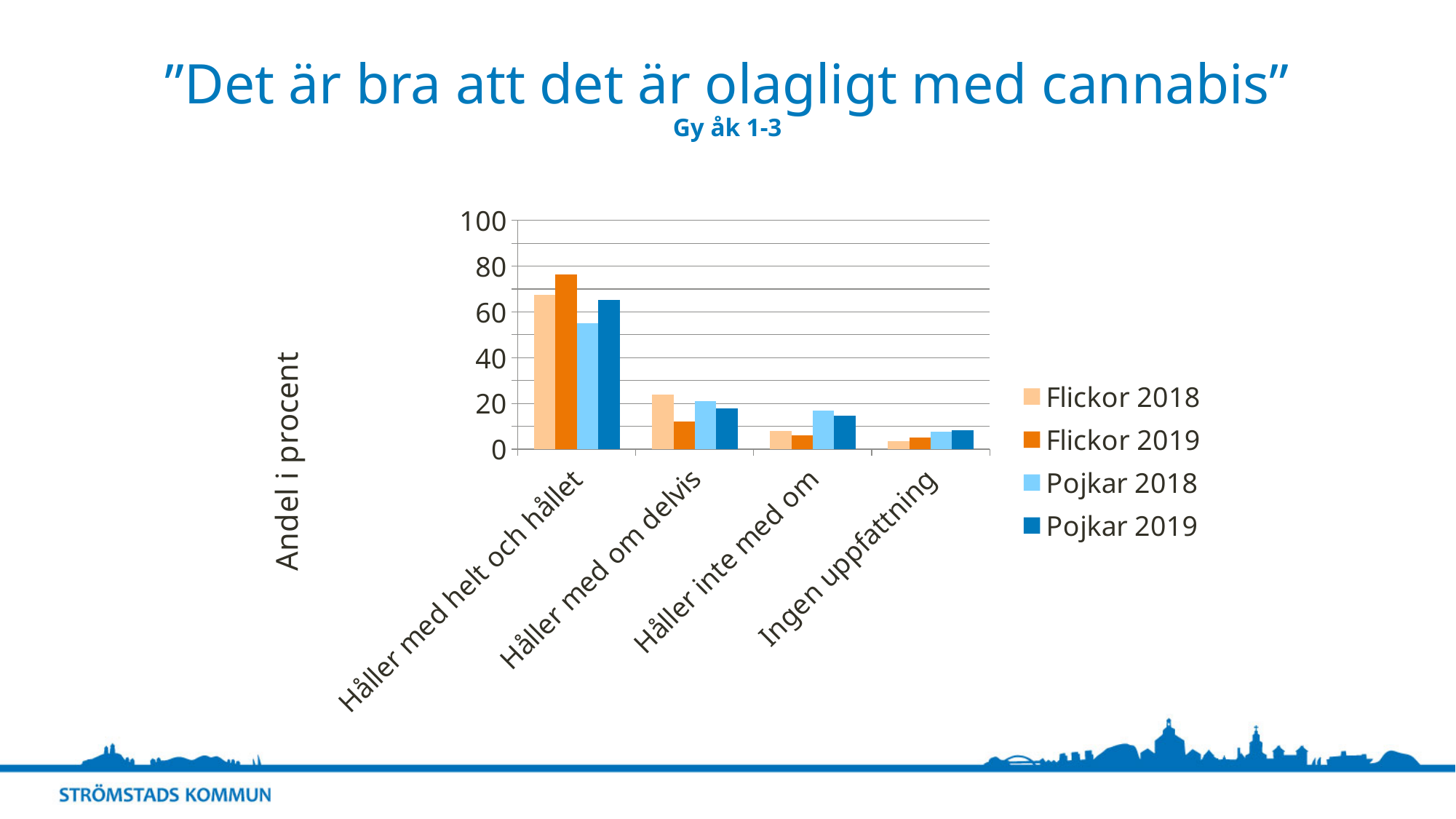
Is the value for Flickor 2019 in "Håller med helt och hållet" greater or less than 60? greater What kind of chart is shown on the slide? bar chart For "Håller med helt och hållet", which series has the lowest bar? Pojkar 2018 How many series does the legend list? 4 What is the label on the vertical axis? Andel i procent Is the value for Flickor 2019 in "Håller med om delvis" greater or less than 20? less How many categories are shown on the x axis? 4 In "Håller med om delvis", which is larger: Flickor 2018 or Flickor 2019? Flickor 2018 Is the value for Pojkar 2018 in "Håller med helt och hållet" greater or less than 60? less Which category has the highest bars overall? Håller med helt och hållet For "Håller med helt och hållet", which series has the highest bar? Flickor 2019 In "Håller inte med om", which is larger: Pojkar 2018 or Flickor 2018? Pojkar 2018